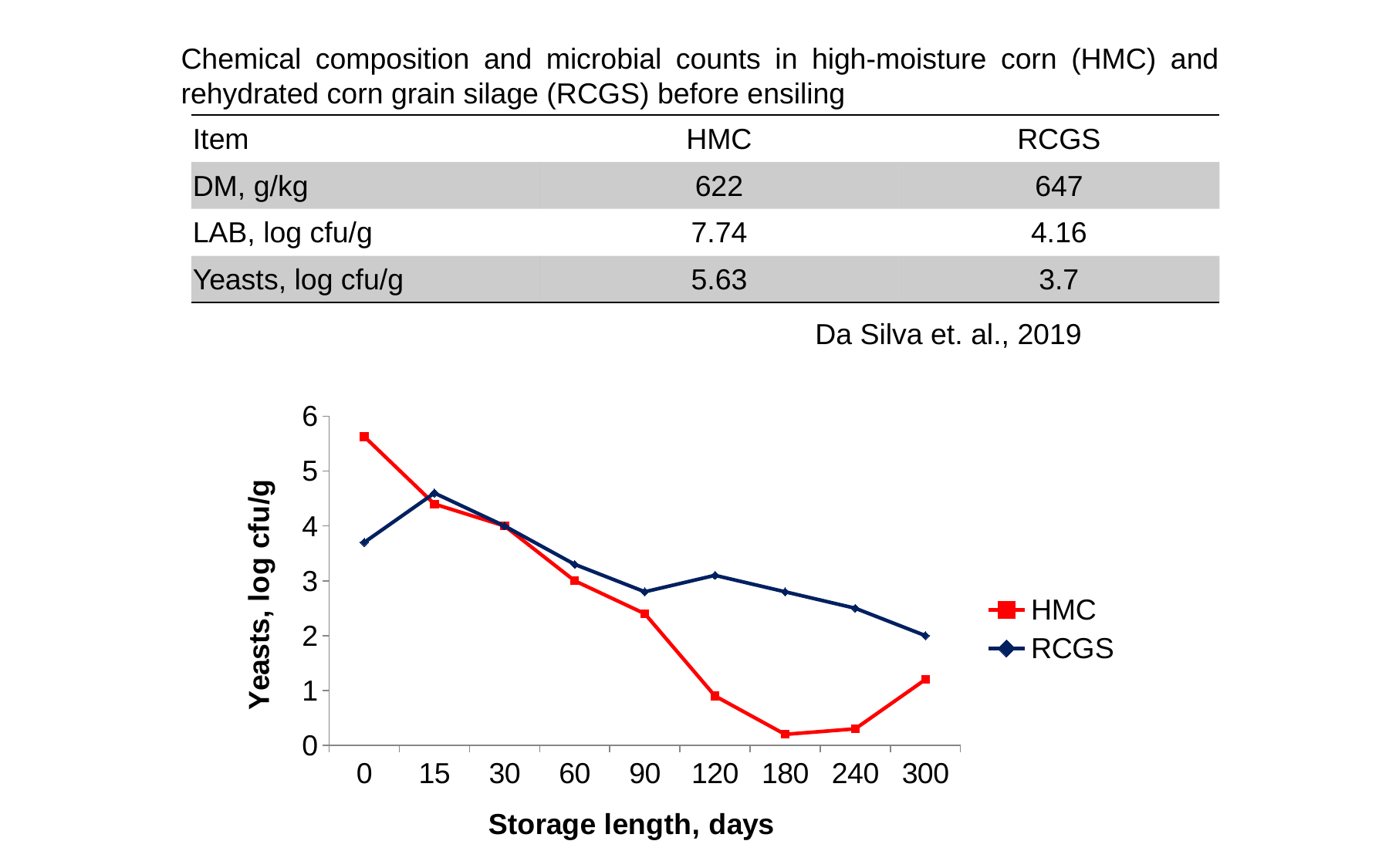
What kind of chart is shown on the slide? line chart At which storage length is the HMC yeast count highest? 0 How many storage-length points are plotted along the x axis of the chart? 9 How many series does the chart legend list? 2 At which storage length is the HMC yeast count lowest? 180 At 180 days of storage, which series has the higher yeast count, HMC or RCGS? RCGS Does the HMC yeast count rise or fall from 0 to 180 days of storage? fall At 0 days of storage, which series has the higher yeast count, HMC or RCGS? HMC At which storage length is the RCGS yeast count lowest? 300 What is the title of the chart's y axis? Yeasts, log cfu/g